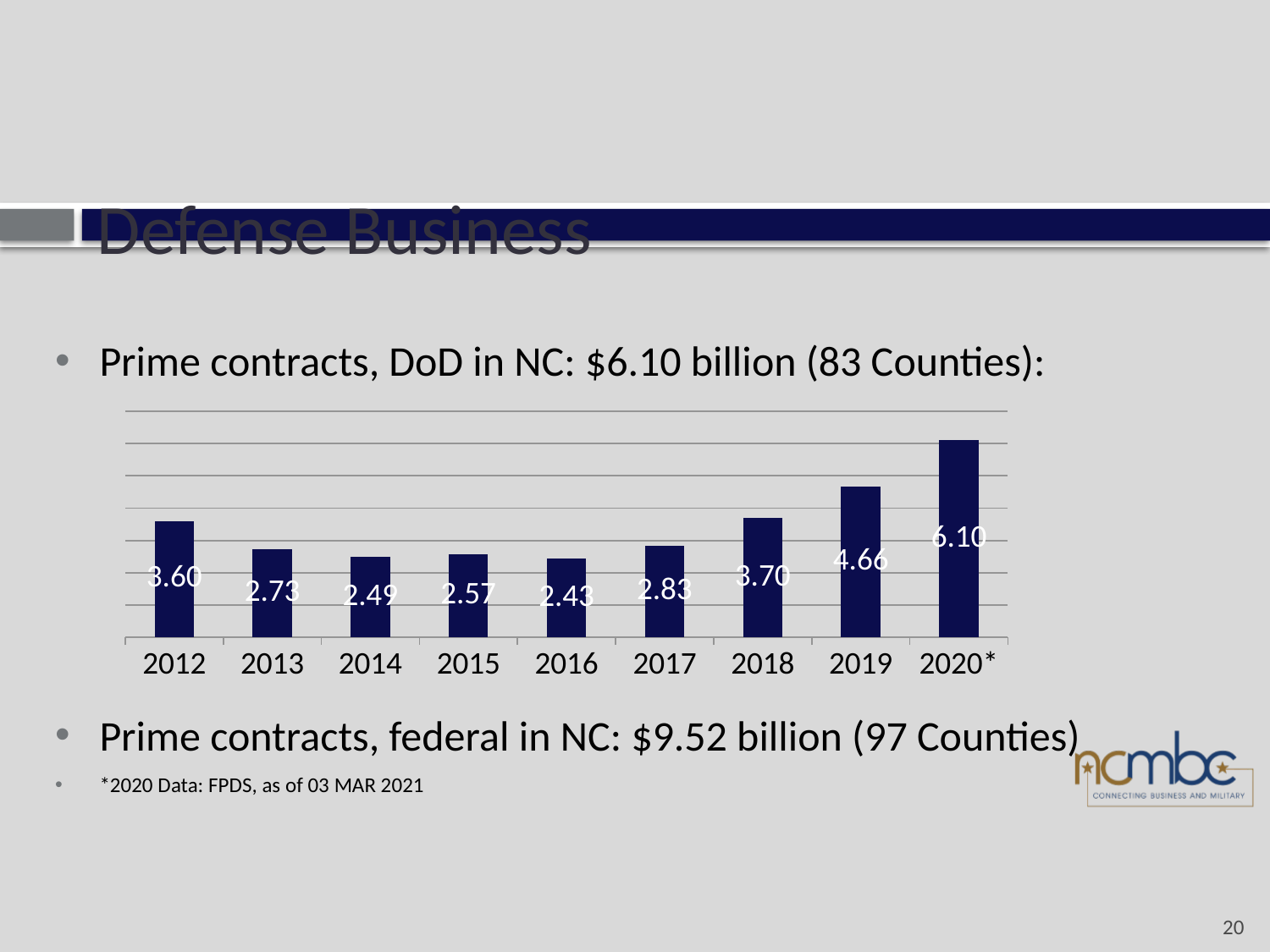
What is the difference between the values for 2020* and 2019? 1.44 Which is larger, the value for 2018 or the value for 2017? 2018 Which year has the lowest value? 2016 What is the difference between the values for 2012 and 2013? 0.87 What is the value for 2012? 3.60 What kind of chart is shown on the slide? bar chart What is the value for 2020*? 6.10 Which year has the highest value? 2020* How many years are shown on the x axis? 9 What is the value for 2016? 2.43 What is the value for 2019? 4.66 Do the values rise or fall from 2016 to 2020*? rise